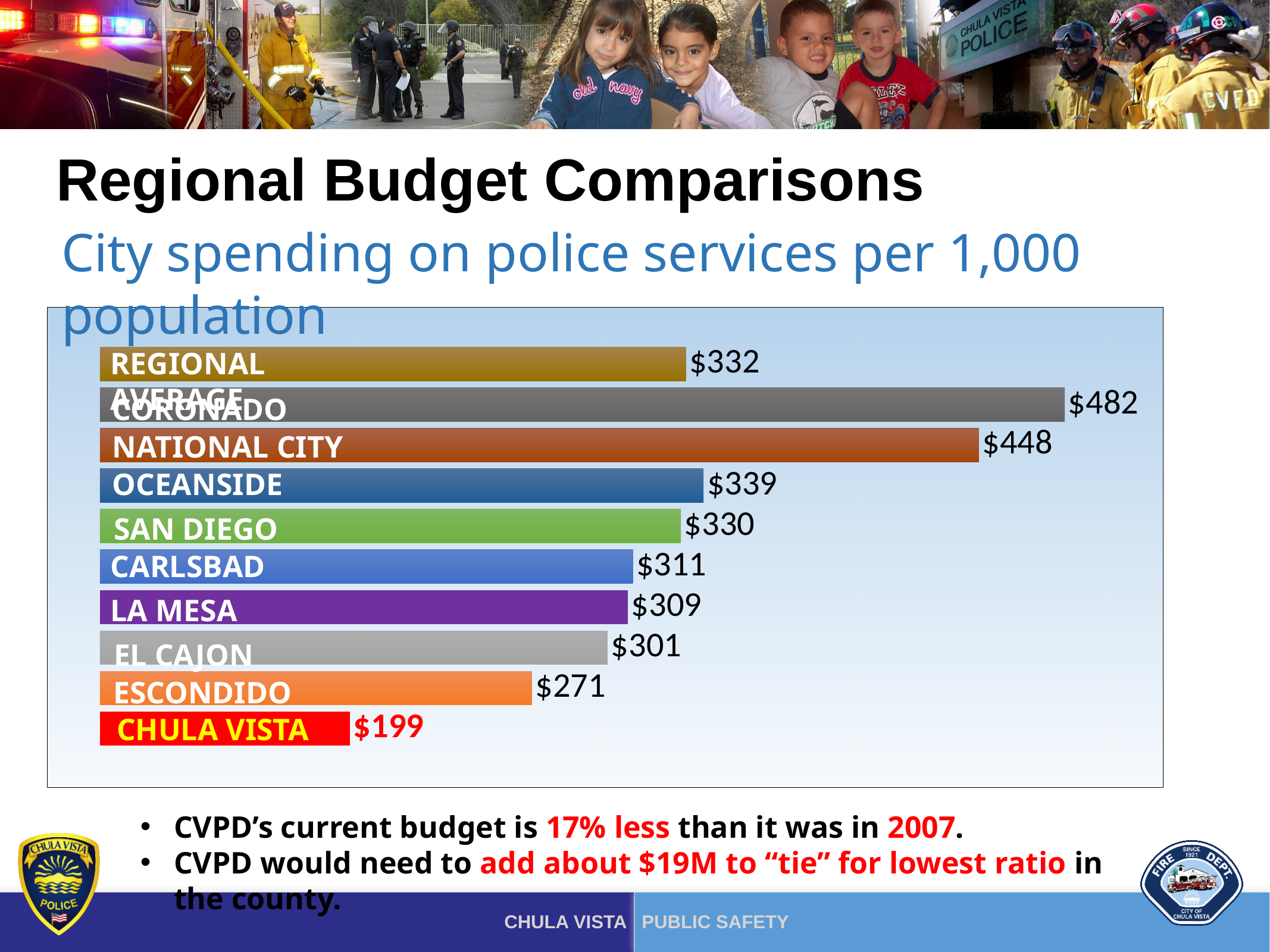
What is the difference between Oceanside's value and San Diego's value? $9 What is the value for Chula Vista? $199 Which city has the highest spending on police services per 1,000 population? Coronado What is the value for Escondido? $271 How many bars are shown in the chart? 10 What colour is the Chula Vista bar? Red Which is larger, the value for Carlsbad or the value for La Mesa? Carlsbad What kind of chart is shown on the slide? Bar chart What is the value for Coronado? $482 What is the value for National City? $448 What is the difference between Coronado's value and Chula Vista's value? $283 Which city has the lowest spending on police services per 1,000 population? Chula Vista